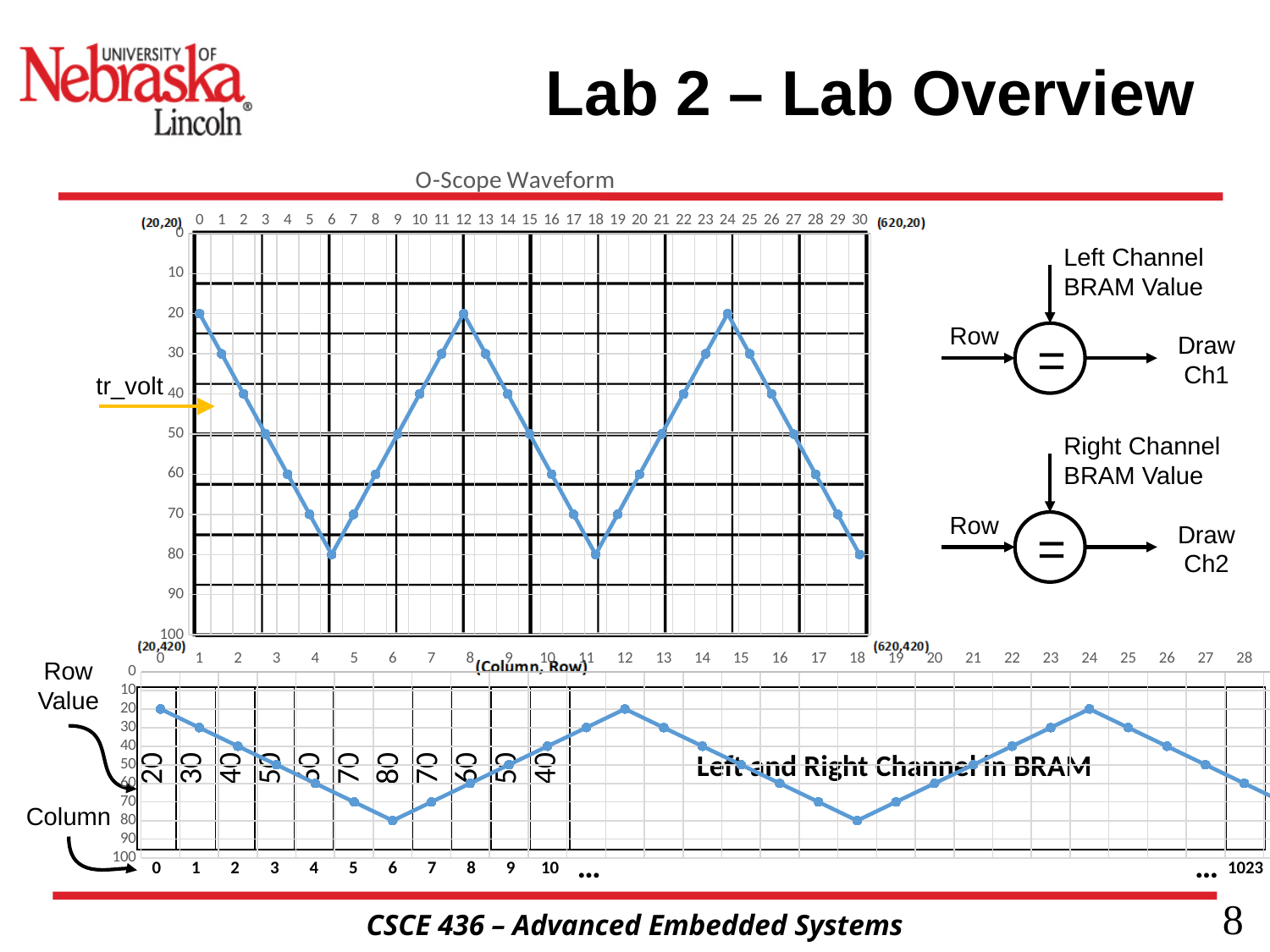
In the "Left and Right Channel in BRAM" chart, what is the row value at column 6? 80 In the "Left and Right Channel in BRAM" chart, what is the row value at column 0? 20 In the "O-Scope Waveform" chart, is the value at x = 3 greater or less than 40? greater In the "O-Scope Waveform" chart, what value does the waveform reach at x = 6? 80 What is the title of the top chart on the slide? O-Scope Waveform In the "Left and Right Channel in BRAM" chart, which of the labeled columns 0 to 10 has the highest row value? column 6 What kind of chart is the "O-Scope Waveform" chart? line chart In the "Left and Right Channel in BRAM" chart, what is the lowest row value among the printed data labels? 20 In the "O-Scope Waveform" chart, what value does the waveform have at x = 12? 20 In the "Left and Right Channel in BRAM" chart, which has the larger row value, column 2 or column 5? column 5 In the "O-Scope Waveform" chart, do the values increase or decrease from x = 0 to x = 6? increase In the "Left and Right Channel in BRAM" chart, what is the difference between the row value at column 6 and the row value at column 0? 60